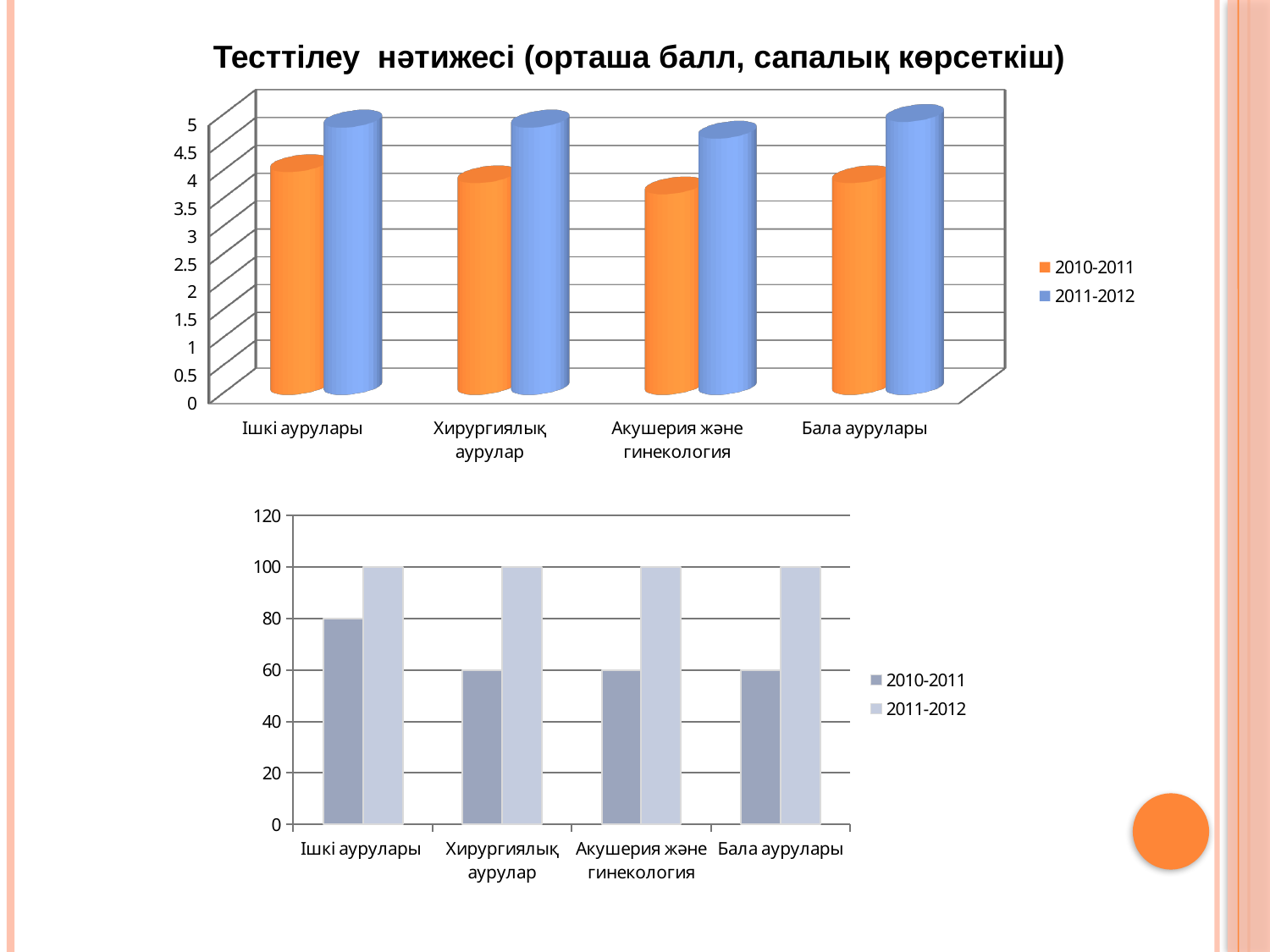
What kind of chart is the bottom chart? Bar chart In the bottom chart, what is the value for Бала аурулары in the 2010-2011 series? 60 What are the two legend entries in the top chart? 2010-2011 and 2011-2012 How many series does the legend of the bottom chart list? 2 In the top chart, is the 2010-2011 value for Ішкі аурулары greater or less than 3? greater In the bottom chart, what is the difference between the 2011-2012 and 2010-2011 values for Ішкі аурулары? 20 In the bottom chart, which is larger for Акушерия және гинекология: the 2010-2011 value or the 2011-2012 value? 2011-2012 How many categories are shown on the x axis of the top chart? 4 In the bottom chart, which category has the highest value in the 2010-2011 series? Ішкі аурулары In the top chart, is the 2011-2012 value for Бала аурулары greater or less than 4? greater In the bottom chart, what is the value for Хирургиялық аурулар in the 2011-2012 series? 100 In the bottom chart, what is the value for Ішкі аурулары in the 2010-2011 series? 80